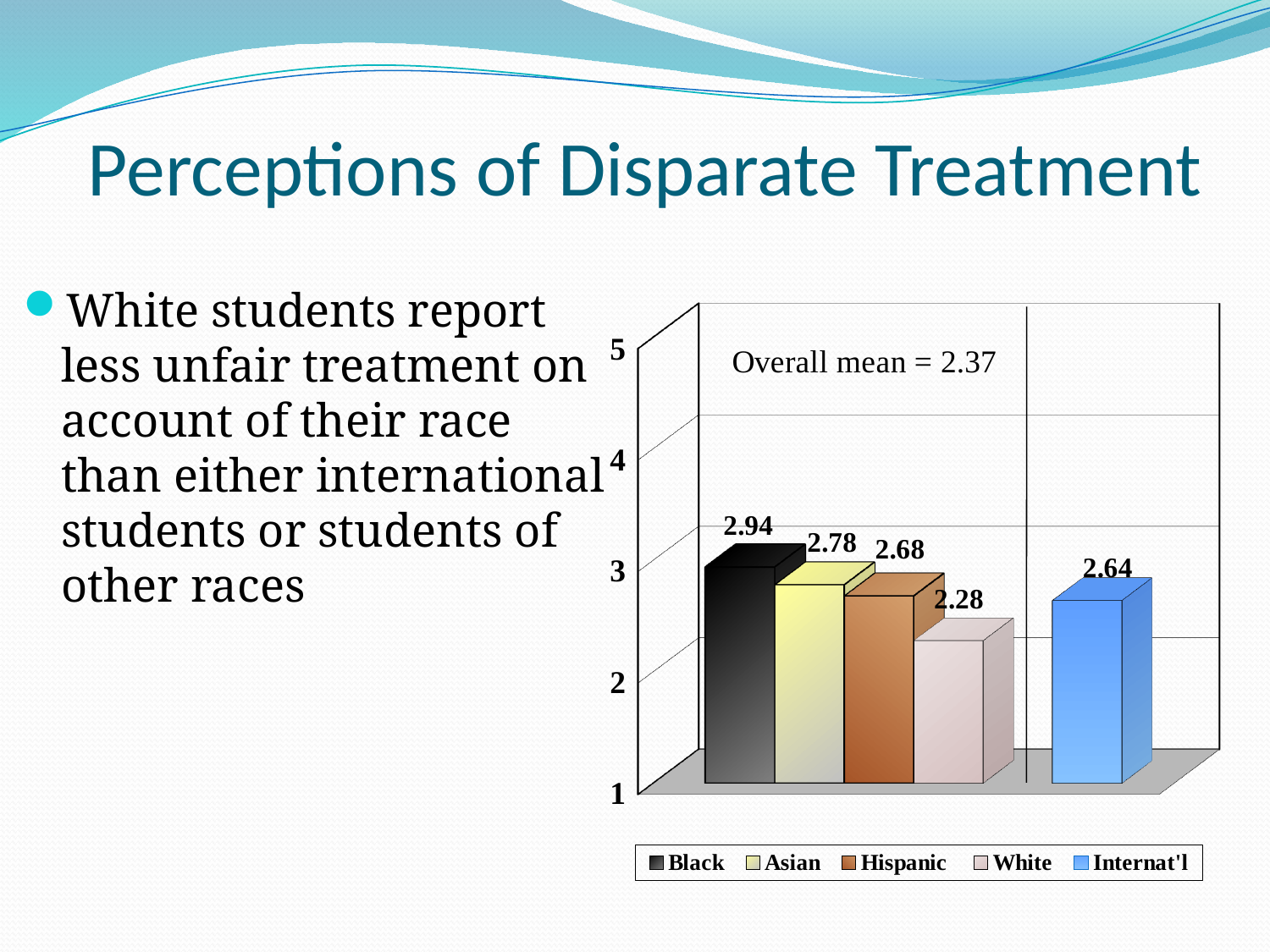
What kind of chart is shown on the slide? bar chart Which group has the lowest value? White What is the value for White? 2.28 Which is larger, the value for Asian or the value for Internat'l? Asian What is the value for Black? 2.94 What is the difference between the values for Black and White? 0.66 How many groups are shown in the chart? 5 How many entries does the legend list? 5 Is the value for Hispanic greater or less than 2? greater Which group has the highest value? Black What overall mean is stated on the chart? 2.37 What is the value for Internat'l? 2.64